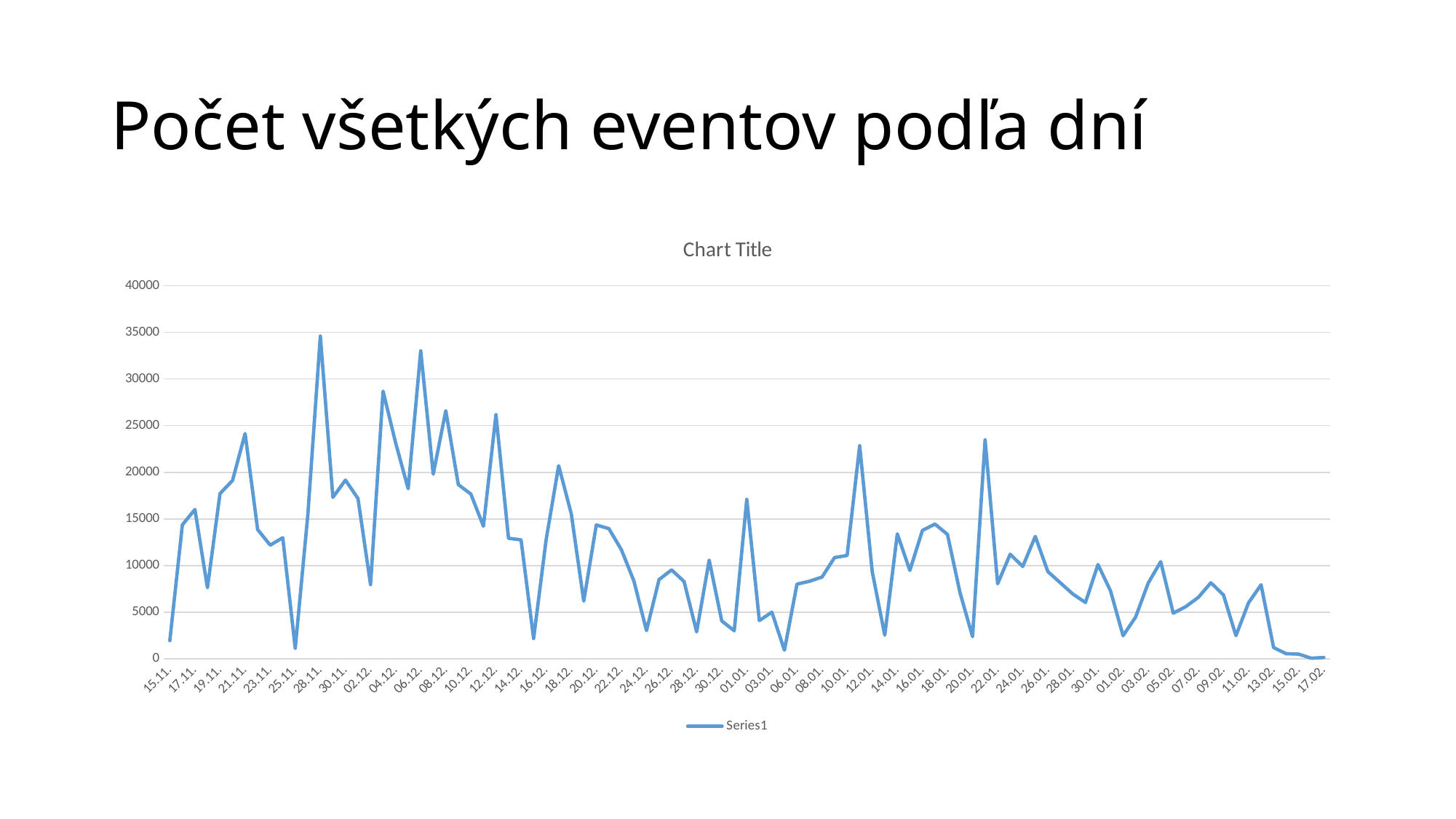
Is the value for 17.02. greater or less than 5000? less What title is printed above the chart? Chart Title Which is larger, the value for 15.11. or the highest value reached in late November? the highest value in late November What is the name of the series shown in the legend? Series1 Is the highest value on the chart greater or less than 30000? greater Is the value for 15.11. greater or less than 10000? less How many series does the legend list? 1 What is the maximum value shown on the vertical axis? 40000 What kind of chart is shown on the slide? line chart Do the values generally rise or fall along the x axis from December to February? fall